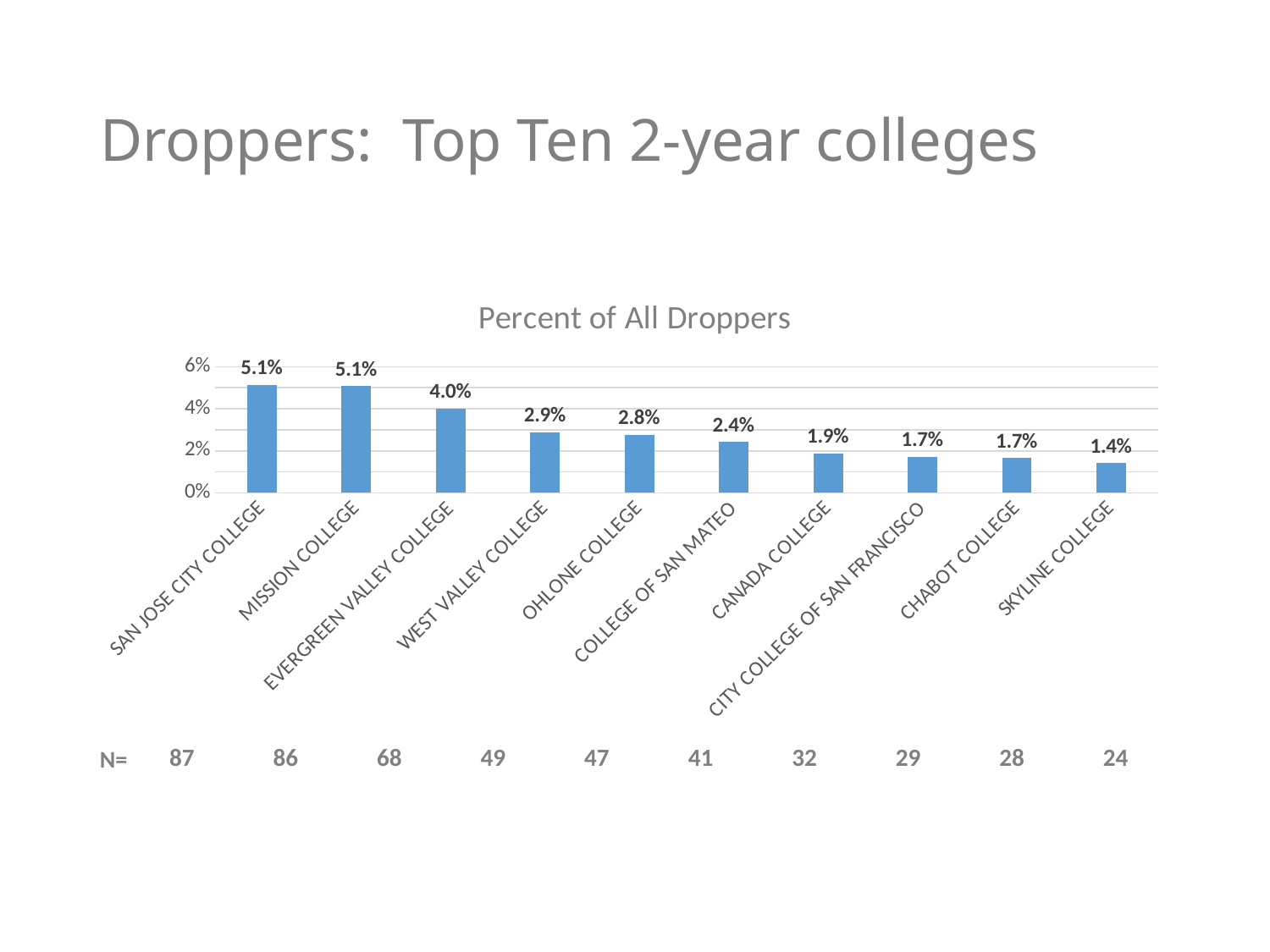
What is the value shown for Skyline College? 1.4% Which college has the lowest percent of all droppers? Skyline College How many colleges are shown in the chart? 10 Is the value for Evergreen Valley College greater or less than 2%? greater What is the difference between the values for College of San Mateo and Skyline College? 1.0% Do the values rise or fall from left to right across the chart? fall What is the title of the chart? Percent of All Droppers Which has a larger value, Ohlone College or College of San Mateo? Ohlone College What is the difference between the values for Evergreen Valley College and West Valley College? 1.1% What is the value for Evergreen Valley College in the Percent of All Droppers chart? 4.0% What percent of all droppers does Canada College account for? 1.9% What kind of chart is shown on the slide? bar chart